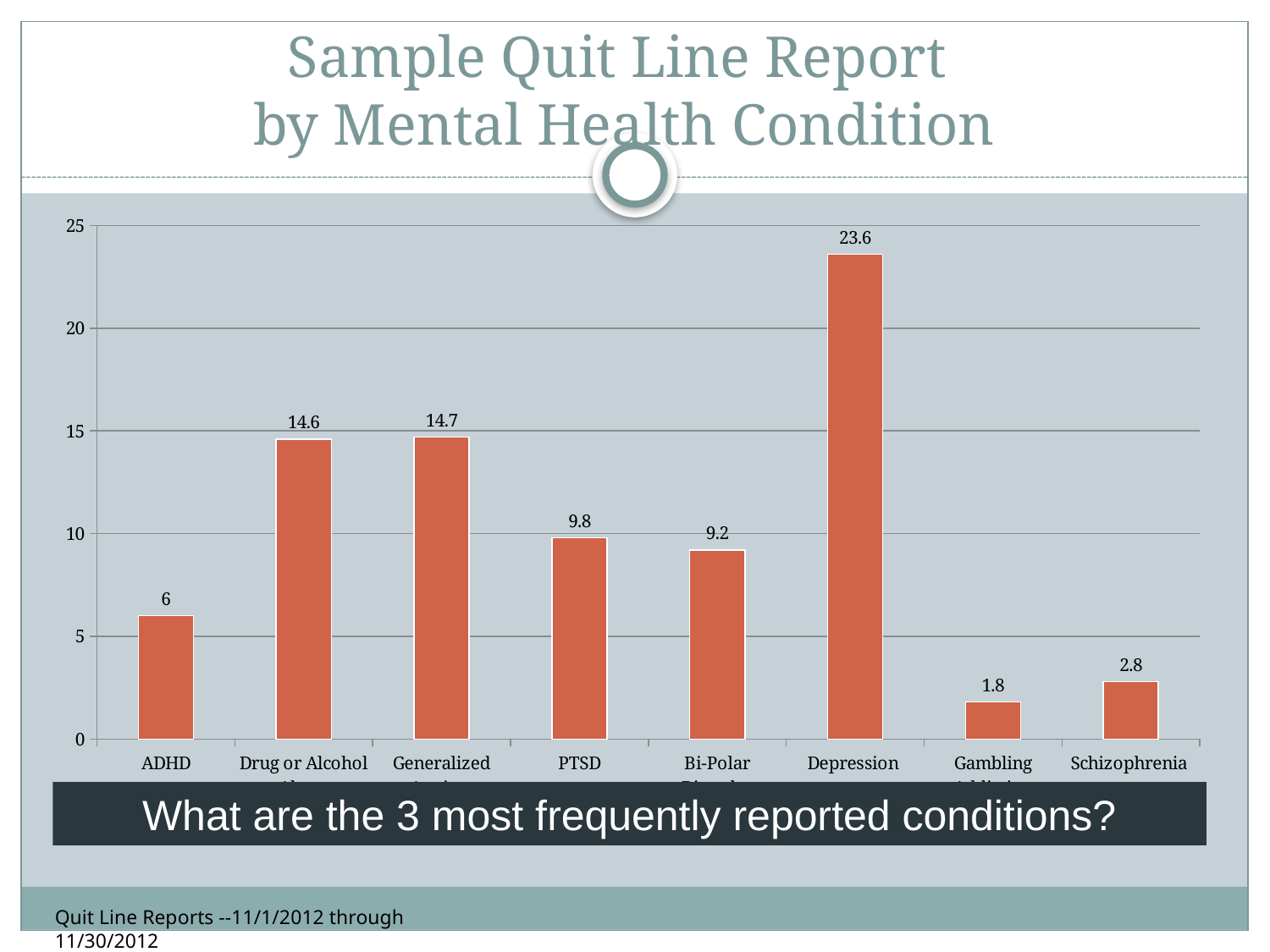
What is the difference between the values for Generalized and Drug or Alcohol? 0.1 What is the value for Depression? 23.6 Is the value for Depression greater or less than 20? greater What is the value for ADHD? 6 What kind of chart is shown on the slide? bar chart Which is larger, the value for PTSD or the value for Bi-Polar? PTSD Which condition has the highest value? Depression What is the value for PTSD? 9.8 What is the difference between the values for Depression and PTSD? 13.8 Which condition has the lowest value? Gambling What is the value for Schizophrenia? 2.8 How many conditions are shown on the x axis? 8